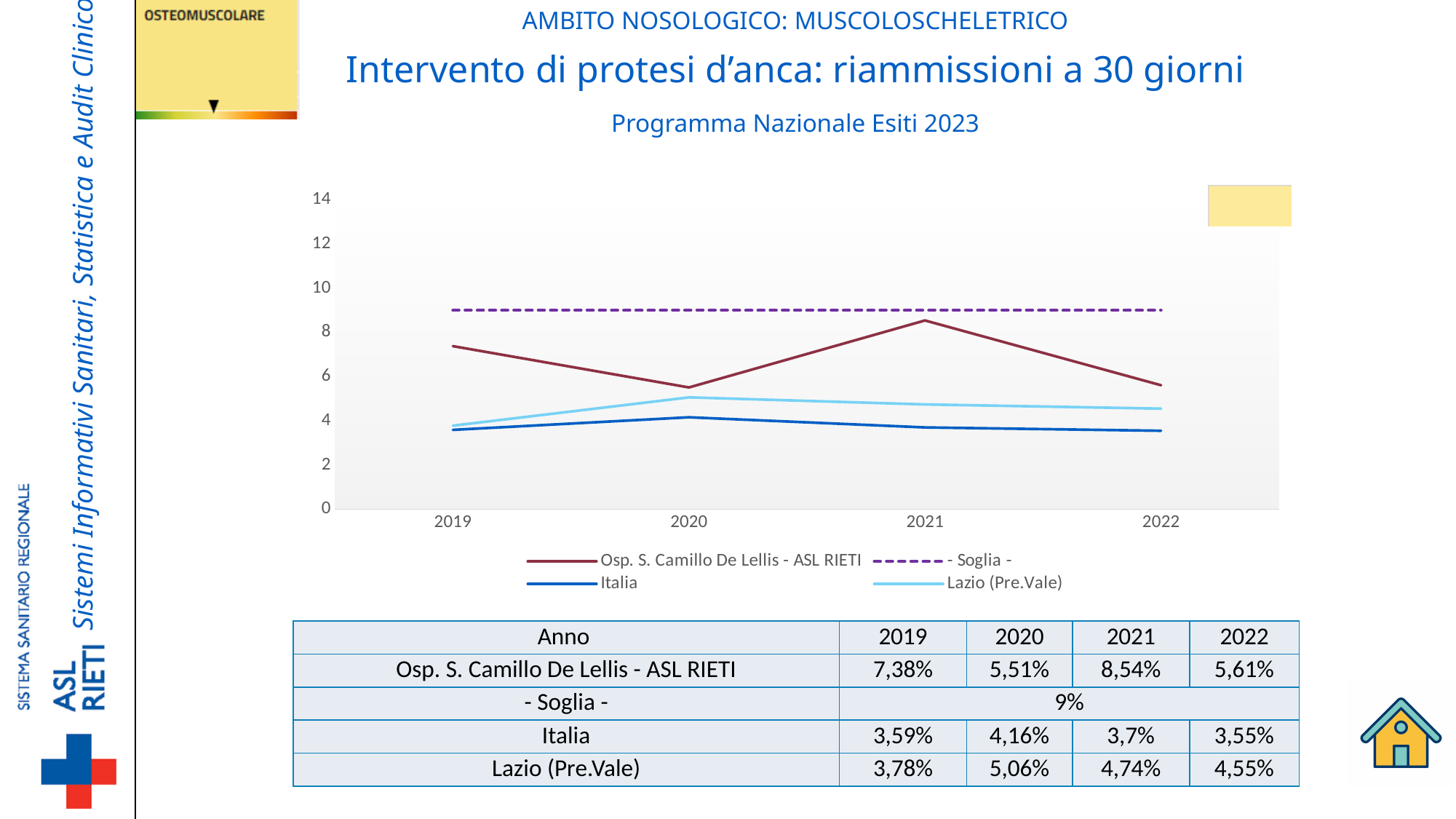
How many years are plotted along the x axis of the chart? 4 What is the difference between the 2021 and 2020 values for Osp. S. Camillo De Lellis - ASL RIETI? 3,03% In 2020, which is larger: the value for Osp. S. Camillo De Lellis - ASL RIETI or the value for Lazio (Pre.Vale)? Osp. S. Camillo De Lellis - ASL RIETI What is the value for Italia in 2020? 4,16% What is the value for Osp. S. Camillo De Lellis - ASL RIETI in 2021? 8,54% In which year is the value for Osp. S. Camillo De Lellis - ASL RIETI highest? 2021 What kind of chart is shown on the slide? line chart How many series does the chart legend list? 4 Does the Osp. S. Camillo De Lellis - ASL RIETI line rise or fall from 2021 to 2022? fall What is the value of the Soglia (threshold) line? 9% In which year is the value for Lazio (Pre.Vale) lowest? 2019 What is the value for Lazio (Pre.Vale) in 2022? 4,55%